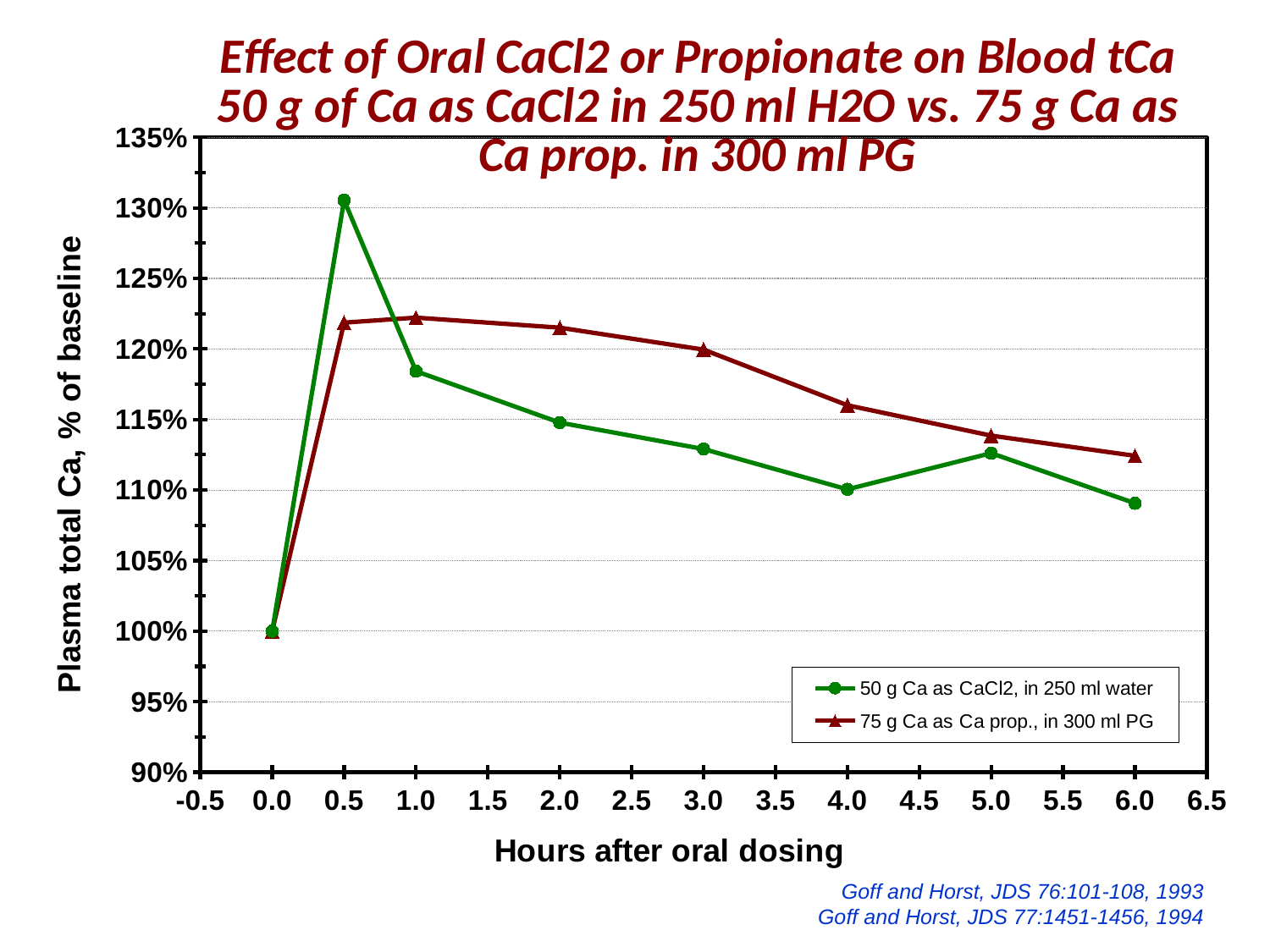
What is the plasma total Ca value for the 50 g Ca as CaCl2 series at 0.0 hours after oral dosing? 100% At how many hours after oral dosing does the 50 g Ca as CaCl2 series have its lowest value? 0.0 What type of chart is shown on the slide? line chart At 3.0 hours after oral dosing, which series has the higher plasma total Ca value? 75 g Ca as Ca prop., in 300 ml PG Is the value for the 50 g Ca as CaCl2 series at 0.5 hours greater or less than 125%? greater How many data points are plotted for the 50 g Ca as CaCl2 series? 8 At 0.5 hours after oral dosing, which series has the higher plasma total Ca value? 50 g Ca as CaCl2, in 250 ml water Is the value for the 50 g Ca as CaCl2 series at 2.0 hours greater or less than 120%? less At how many hours after oral dosing does the 50 g Ca as CaCl2 series reach its highest value? 0.5 Between 1.0 and 6.0 hours, do the values for the 75 g Ca as Ca prop. series rise or fall? fall Is the value for the 75 g Ca as Ca prop. series at 0.5 hours greater or less than 120%? greater How many series does the legend list? 2